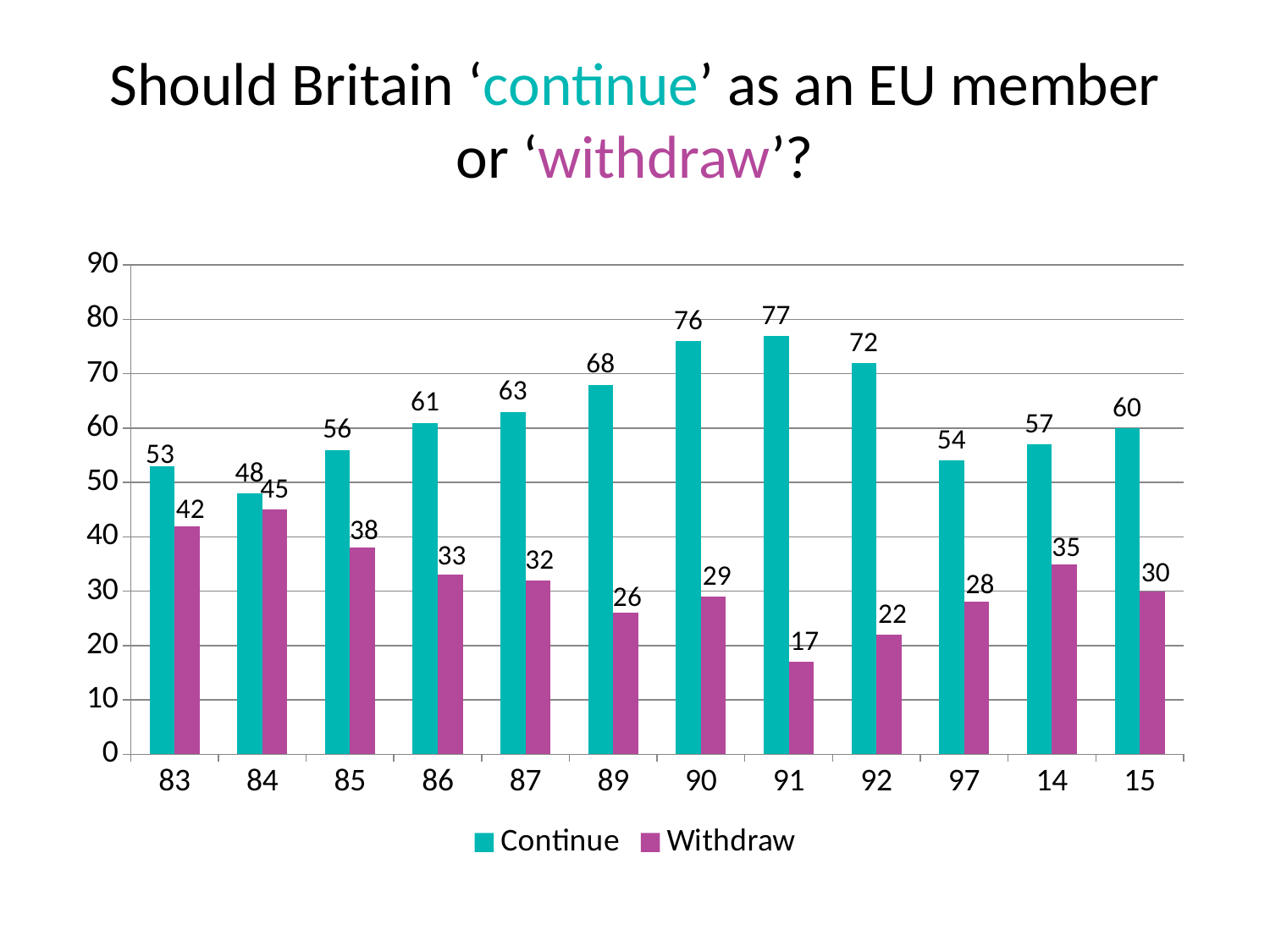
What colour are the Withdraw bars? Purple How many series does the legend list? 2 What is the value for Withdraw in 84? 45 Which is larger in 84, Continue or Withdraw? Continue Does the Continue value rise or fall from 83 to 91? Rise What is the difference between Continue and Withdraw in 90? 47 How many years are shown on the x axis? 12 In which year is the Withdraw value lowest? 91 What kind of chart is shown on the slide? Bar chart What is the value for Continue in 91? 77 What is the value for Withdraw in 15? 30 In which year is the Continue value highest? 91